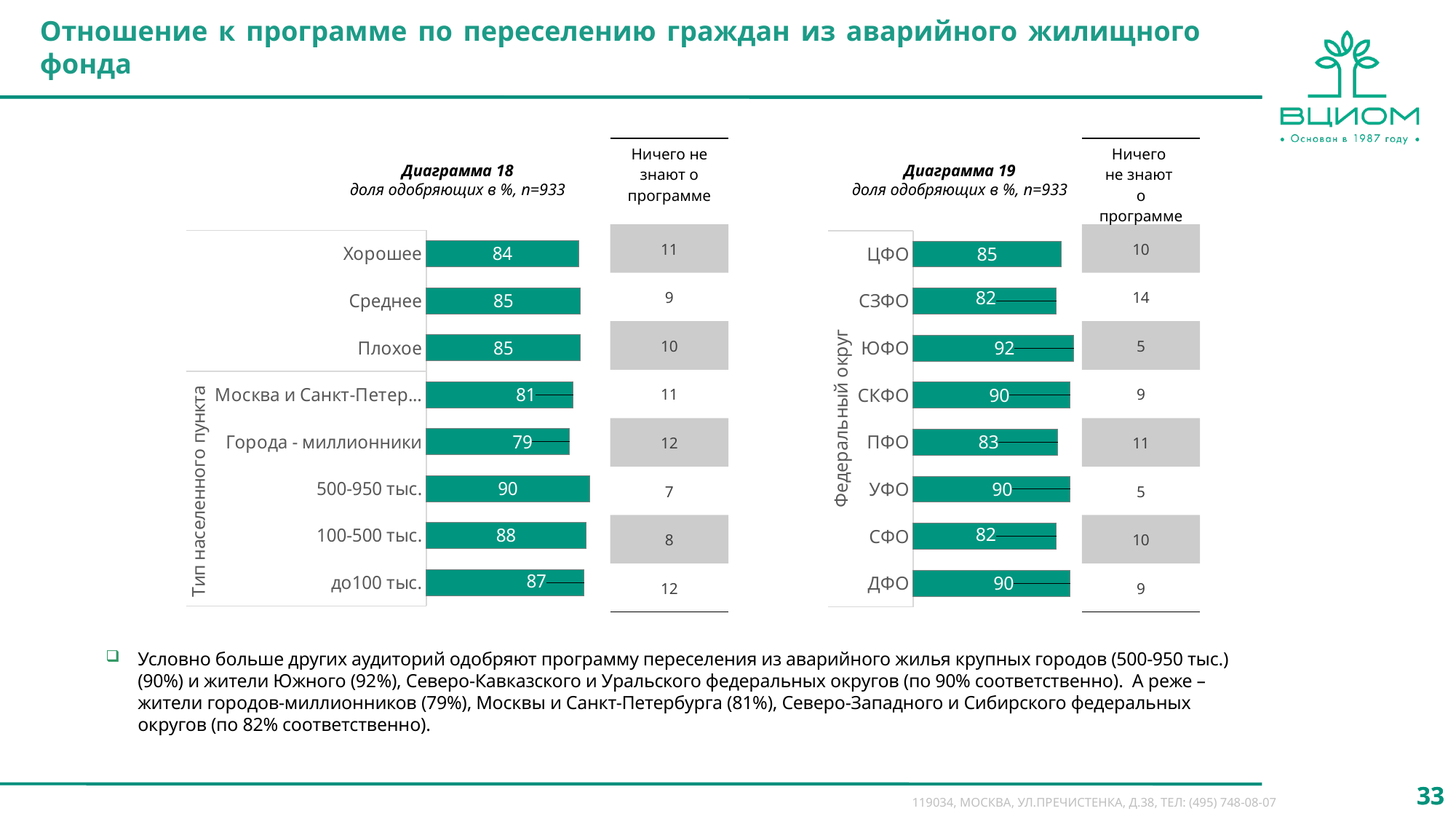
In Диаграмма 18, what is the value for Города - миллионники? 79 In Диаграмма 18, what is the value for 100-500 тыс.? 88 In Диаграмма 18, what is the difference between the values for 500-950 тыс. and Города - миллионники? 11 In Диаграмма 19, which federal district has the highest value? ЮФО In Диаграмма 18, which category has the lowest value? Города - миллионники In Диаграмма 19, what is the value for ЮФО? 92 In Диаграмма 19, what is the difference between the values for ЮФО and СФО? 10 In Диаграмма 19, what is the value for ПФО? 83 What type of chart is Диаграмма 19? Bar chart In Диаграмма 19, which is larger, the value for ЦФО or the value for СЗФО? ЦФО In Диаграмма 18, which category has the highest value? 500-950 тыс. In Диаграмма 18, how many categories are plotted? 8